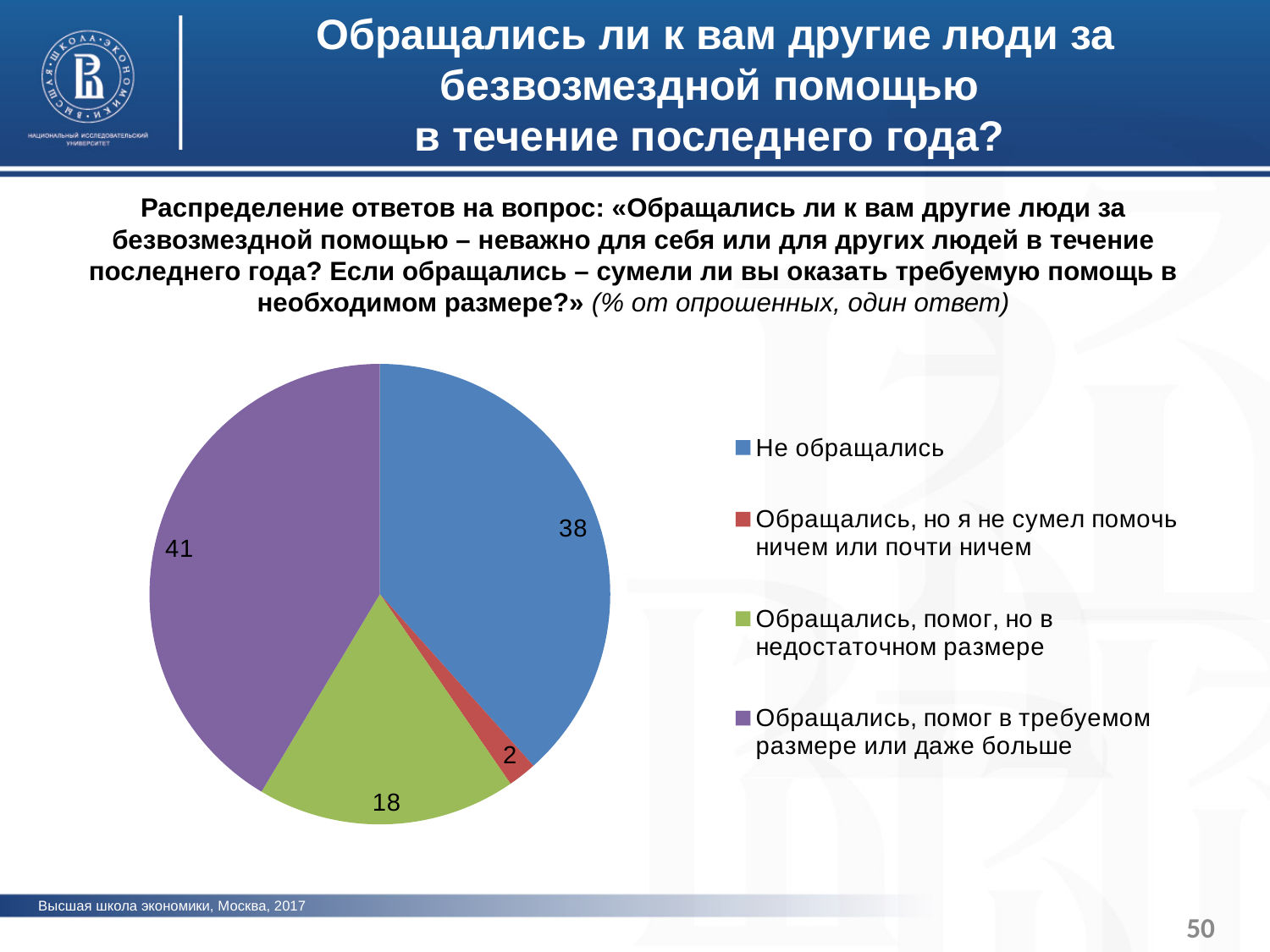
What is the value for «Обращались, но я не сумел помочь ничем или почти ничем»? 2 Which category has the largest share of the pie? Обращались, помог в требуемом размере или даже больше What is the difference between the values for «Обращались, помог в требуемом размере или даже больше» and «Не обращались»? 3 What kind of chart is shown on the slide? Pie chart What is the value for «Обращались, помог, но в недостаточном размере»? 18 What is the value for «Обращались, помог в требуемом размере или даже больше»? 41 Which category has the smallest share of the pie? Обращались, но я не сумел помочь ничем или почти ничем What colour is the slice for «Не обращались»? Blue Which is larger: the value for «Не обращались» or the value for «Обращались, помог, но в недостаточном размере»? Не обращались What is the value for «Не обращались»? 38 How many categories does the legend list? 4 What is the difference between the values for «Не обращались» and «Обращались, помог, но в недостаточном размере»? 20